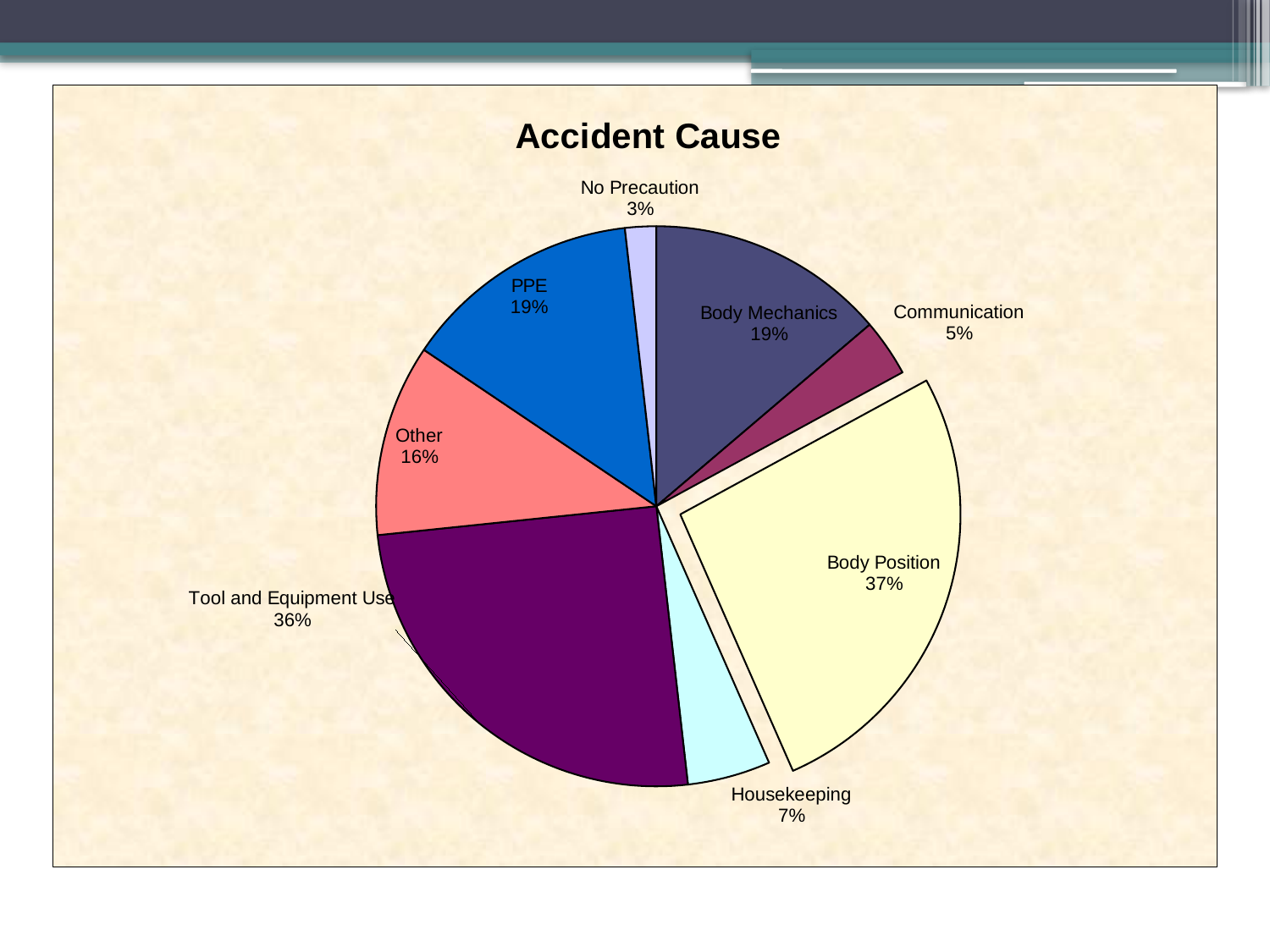
Which accident cause has the smallest slice of the pie? No Precaution Which is larger, the share for PPE or the share for Other? PPE What share of the pie does Body Position account for? 37% What is the difference in percentage points between Body Position and Housekeeping? 30% Which accident cause has the largest slice of the pie? Body Position What percentage is shown for Tool and Equipment Use? 36% Which slice is pulled out (exploded) from the rest of the pie? Body Position What kind of chart is shown on the slide? pie chart What percentage is shown for Communication? 5% How many slices does the pie chart have? 8 What percentage is shown for Housekeeping? 7% What is the title of the chart? Accident Cause